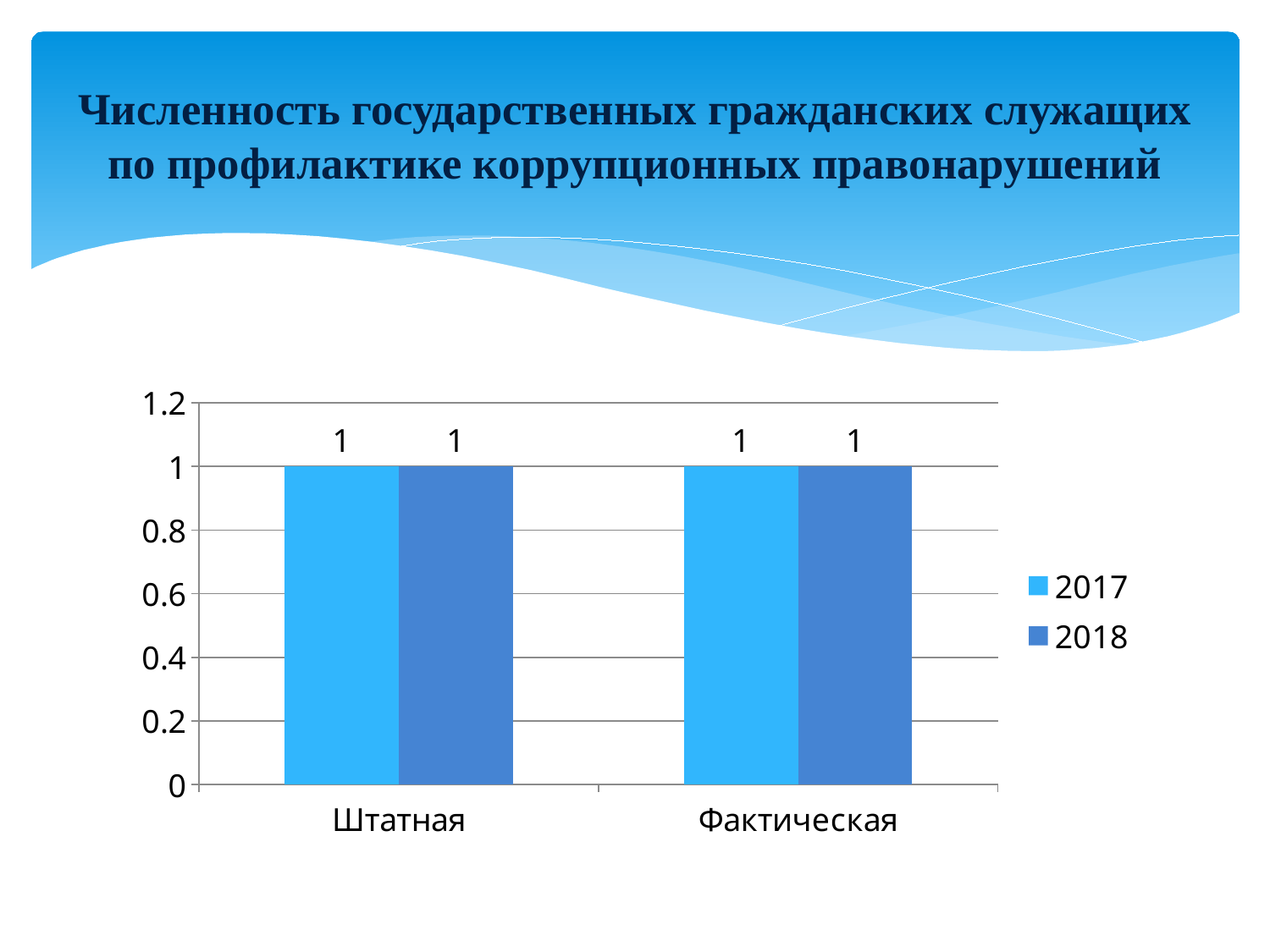
Is the value for Штатная in 2017 greater or less than 0.8? greater What is the value for Штатная in the 2018 series? 1 How many series does the legend list? 2 Is the value for Фактическая in 2018 greater or less than 1.2? less What kind of chart is shown on the slide? bar chart What is the value for Фактическая in the 2017 series? 1 Which series does the legend list first? 2017 What is the difference between the Штатная and Фактическая values in the 2017 series? 0 What is the value for Фактическая in the 2018 series? 1 What is the difference between the 2017 and 2018 values for Штатная? 0 How many categories are shown on the x axis? 2 What is the value for Штатная in the 2017 series? 1